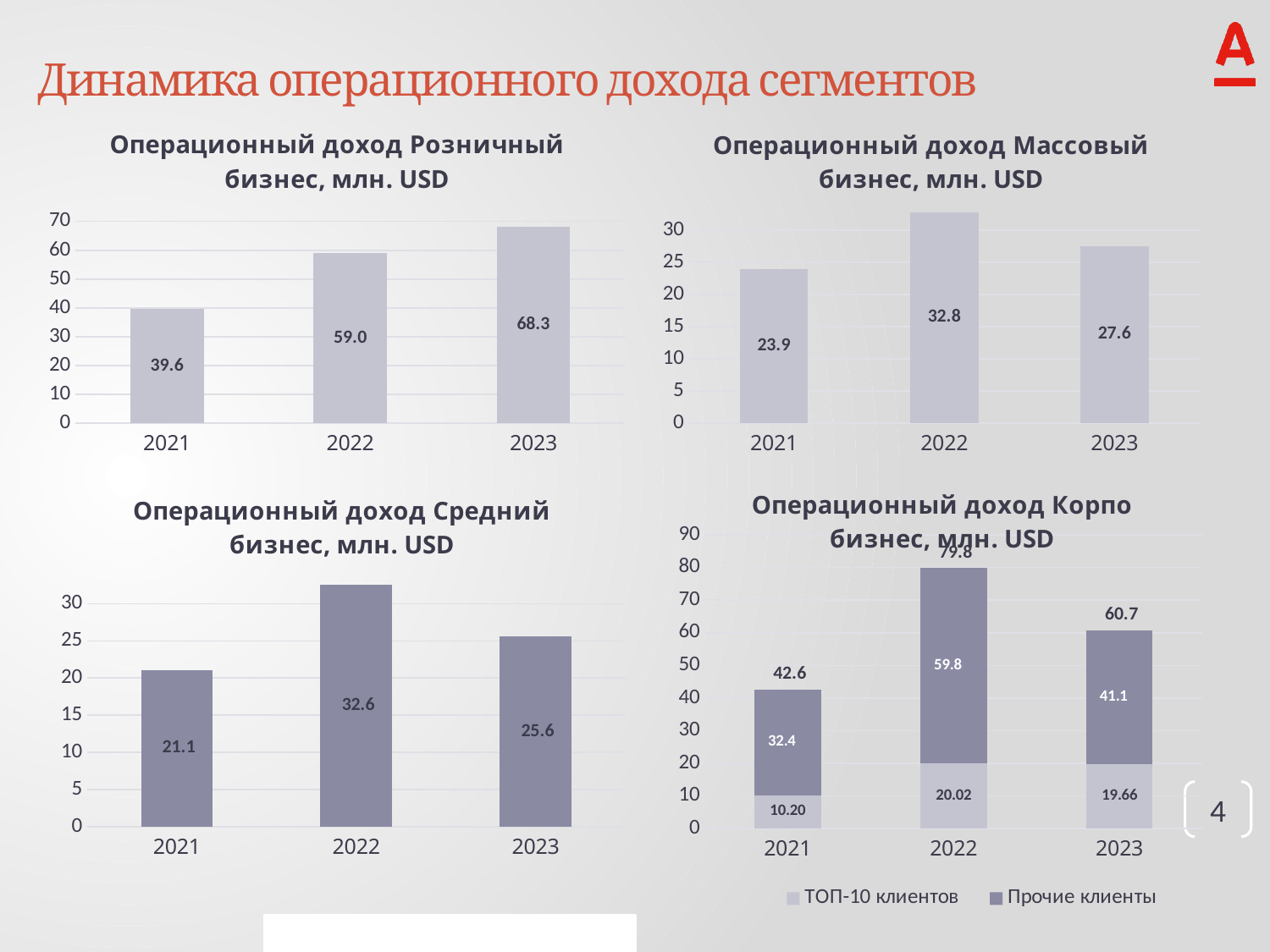
In the chart 'Операционный доход Корпо бизнес, млн. USD', how many series does the legend list? 2 In the chart 'Операционный доход Розничный бизнес, млн. USD', what is the value for 2023? 68.3 In the chart 'Операционный доход Средний бизнес, млн. USD', what is the value for 2022? 32.6 What kind of chart is 'Операционный доход Корпо бизнес, млн. USD'? stacked bar chart In the chart 'Операционный доход Корпо бизнес, млн. USD', what is the total of the stacked bar for 2023? 60.7 In the chart 'Операционный доход Массовый бизнес, млн. USD', what is the value for 2021? 23.9 In the chart 'Операционный доход Розничный бизнес, млн. USD', what is the difference between the 2023 and 2021 values? 28.7 In the chart 'Операционный доход Розничный бизнес, млн. USD', do the values rise or fall from 2021 to 2023? rise In the chart 'Операционный доход Средний бизнес, млн. USD', how many years are shown on the x axis? 3 In the chart 'Операционный доход Корпо бизнес, млн. USD', what is the value for 'Прочие клиенты' in 2022? 59.8 In the chart 'Операционный доход Массовый бизнес, млн. USD', which year has the highest value? 2022 In the chart 'Операционный доход Средний бизнес, млн. USD', which year has the lowest value? 2021